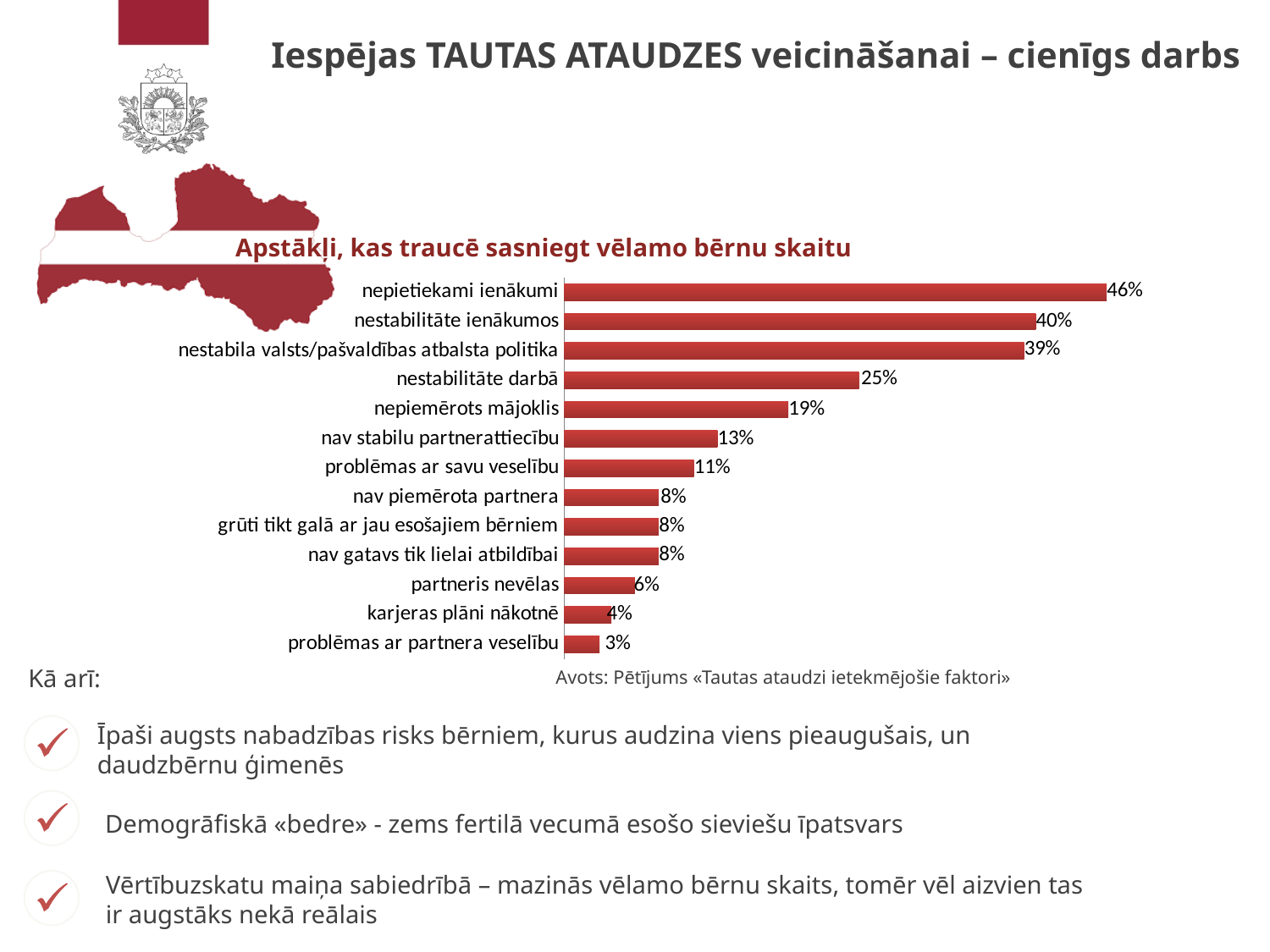
Which category has the lowest value? problēmas ar partnera veselību What kind of chart is shown on the slide? bar chart What is the value for "nestabilitāte darbā"? 25% Which category has the highest value? nepietiekami ienākumi What is the value for "partneris nevēlas"? 6% Which is larger: "nav stabilu partnerattiecību" or "problēmas ar savu veselību"? nav stabilu partnerattiecību What is the value for "nepietiekami ienākumi"? 46% What is the value for "nepiemērots mājoklis"? 19% What is the difference between "nepietiekami ienākumi" and "nestabilitāte darbā"? 21% What is the title of the chart? Apstākļi, kas traucē sasniegt vēlamo bērnu skaitu How many categories are shown in the chart? 13 What is the difference between "nestabilitāte ienākumos" and "nestabila valsts/pašvaldības atbalsta politika"? 1%